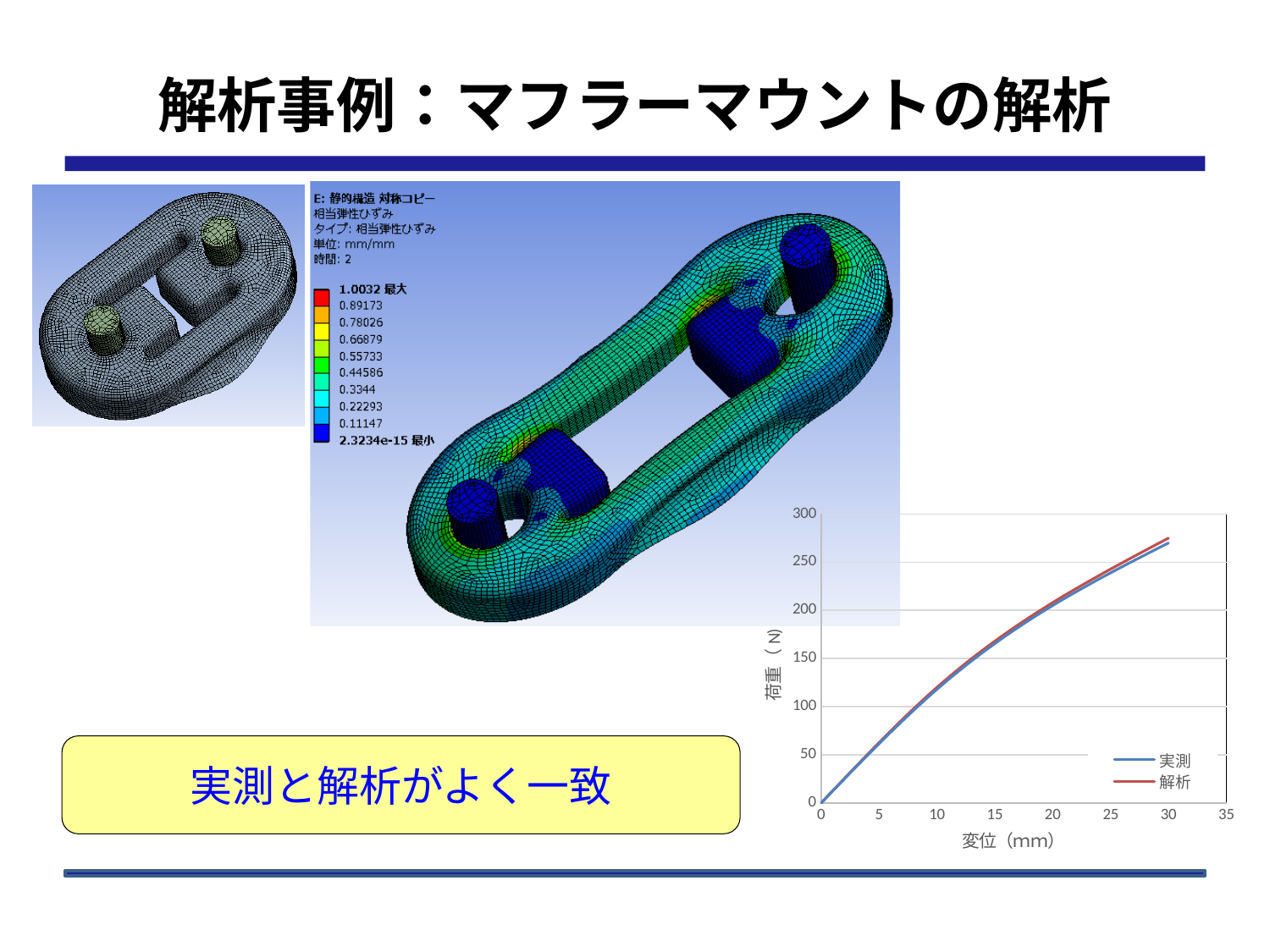
What is the label of the x axis of the line chart? 変位（mm） Is the 実測 value at 30 mm displacement greater or less than 250? greater Is the 実測 value at 10 mm displacement greater or less than 100? greater Is the 解析 value at 20 mm displacement greater or less than 150? greater Does the 実測 line rise or fall as 変位 increases along the x axis? rise How many series does the legend of the line chart list? 2 What kind of chart is shown at the bottom right of the slide? line chart What are the two series named in the legend of the line chart? 実測 and 解析 Does the 解析 line rise or fall as 変位 increases along the x axis? rise